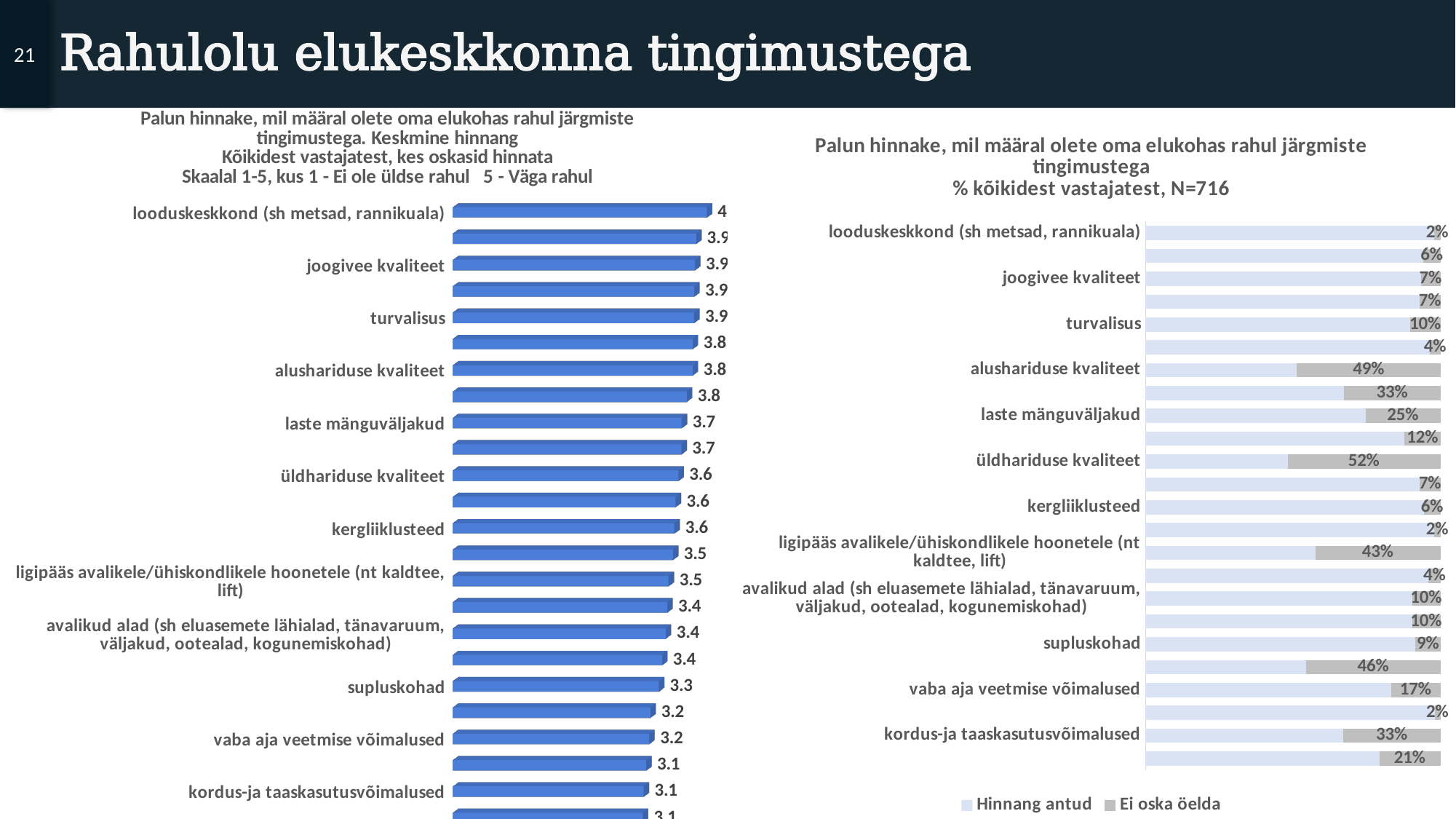
In the right chart (% kõikidest vastajatest), which labelled category has the highest Ei oska öelda share? üldhariduse kvaliteet In the right chart (% kõikidest vastajatest), what is the Ei oska öelda share for ligipääs avalikele/ühiskondlikele hoonetele? 43% How many series does the legend of the right chart list? 2 In the left chart (Keskmine hinnang), what is the average rating for kordus-ja taaskasutusvõimalused? 3.1 In the left chart (Keskmine hinnang), which has a higher rating: alushariduse kvaliteet or avalikud alad? alushariduse kvaliteet In the left chart (Keskmine hinnang), what is the average rating for looduskeskkond (sh metsad, rannikuala)? 4.1 In the left chart (Keskmine hinnang), which labelled category has the highest average rating? looduskeskkond (sh metsad, rannikuala) In the left chart (Keskmine hinnang), what is the difference between the ratings for turvalisus and vaba aja veetmise võimalused? 0.7 What type of chart is the left chart (Keskmine hinnang)? bar chart In the right chart (% kõikidest vastajatest), what is the difference between the Ei oska öelda shares for üldhariduse kvaliteet and alushariduse kvaliteet? 3% In the right chart (% kõikidest vastajatest), what is the Ei oska öelda share for üldhariduse kvaliteet? 52% In the left chart (Keskmine hinnang), what is the average rating for supluskohad? 3.3